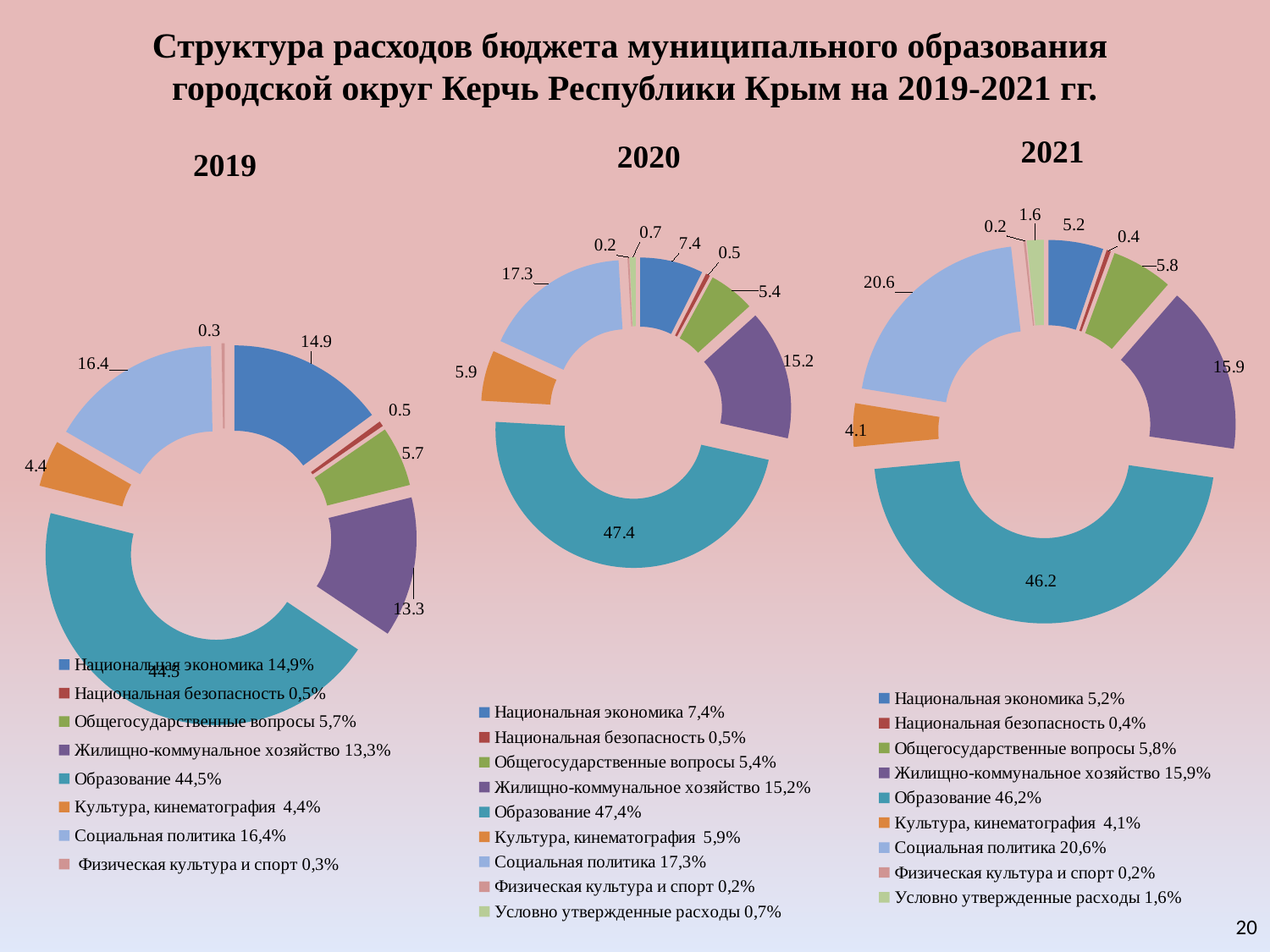
In the 2021 chart, what is the value for Жилищно-коммунальное хозяйство? 15.9 How many categories does the 2019 chart show? 8 In the 2021 chart, which category has the largest share? Образование What kind of chart is used for the 2019 data? Doughnut chart How many categories does the 2020 chart show? 9 In the 2021 chart, which is larger: Социальная политика or Жилищно-коммунальное хозяйство? Социальная политика In the 2019 chart, which category has the smallest share? Физическая культура и спорт In the 2019 chart, what is the difference between the values for Социальная политика and Национальная экономика? 1.5 In the 2020 chart, what is the difference between the values for Образование and Жилищно-коммунальное хозяйство? 32.2 In the 2019 chart, what is the value for Образование? 44.5 In the 2020 chart, what is the value for Социальная политика? 17.3 In the 2020 chart, what is the value for Условно утвержденные расходы? 0.7